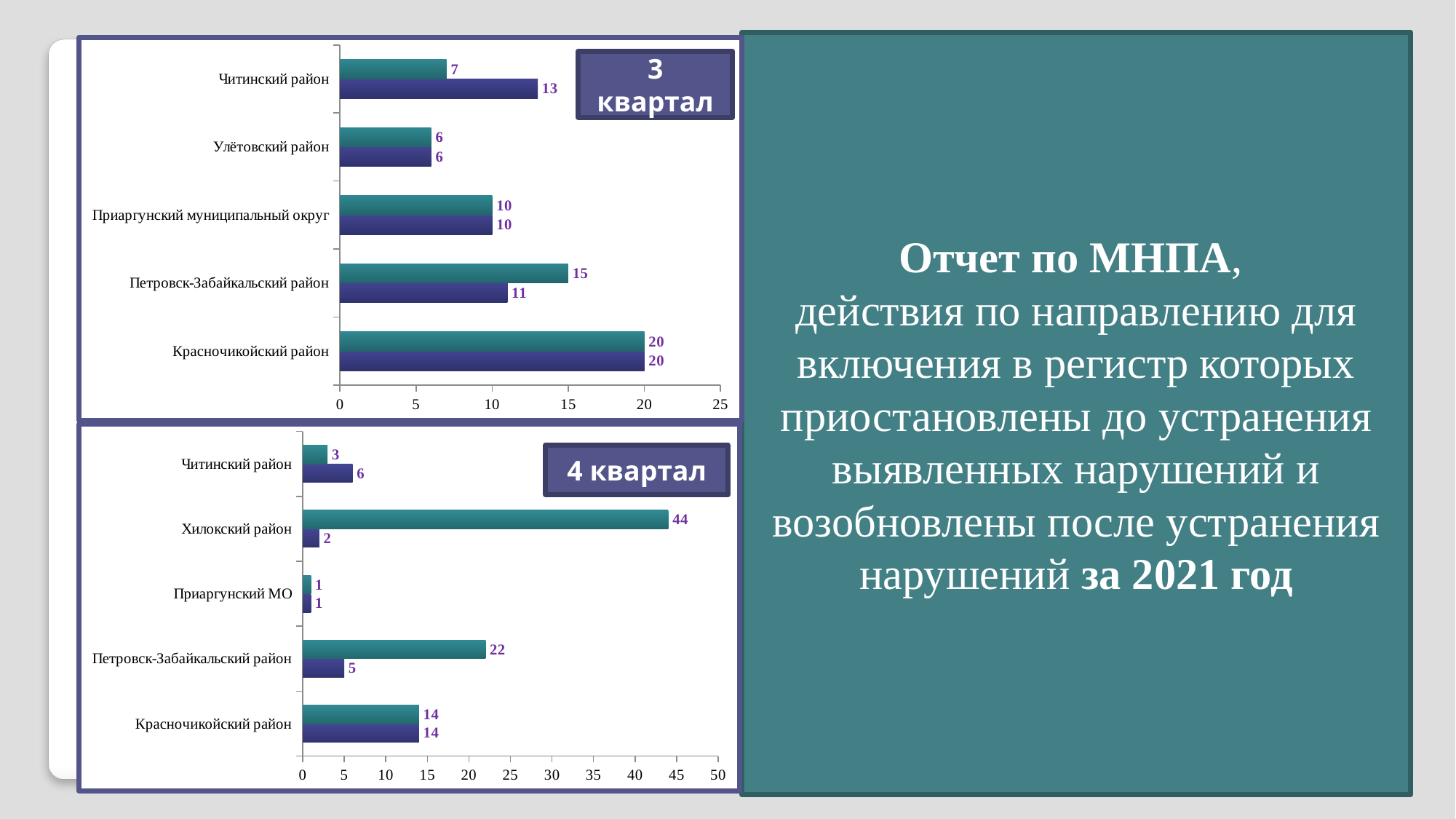
In the "4 квартал" chart, which is larger for Хилокский район: the teal bar or the purple bar? the teal bar In the "4 квартал" chart, what is the difference between the teal bar and the purple bar for Петровск-Забайкальский район? 17 In the "4 квартал" chart, what is the value of the teal bar for Хилокский район? 44 In the "4 квартал" chart, what is the value of the purple bar for Петровск-Забайкальский район? 5 In the "3 квартал" chart, how many categories are shown? 5 In the "3 квартал" chart, what is the value of the teal bar for Читинский район? 7 In the "3 квартал" chart, what is the difference between the purple bar and the teal bar for Читинский район? 6 In the "4 квартал" chart, which category has the lowest values? Приаргунский МО In the "3 квартал" chart, what is the value of the purple bar for Петровск-Забайкальский район? 11 In the "3 квартал" chart, which category has the highest values? Красночикойский район What type of chart is the "4 квартал" chart? bar chart In the "4 квартал" chart, what is the maximum value shown on the x axis? 50